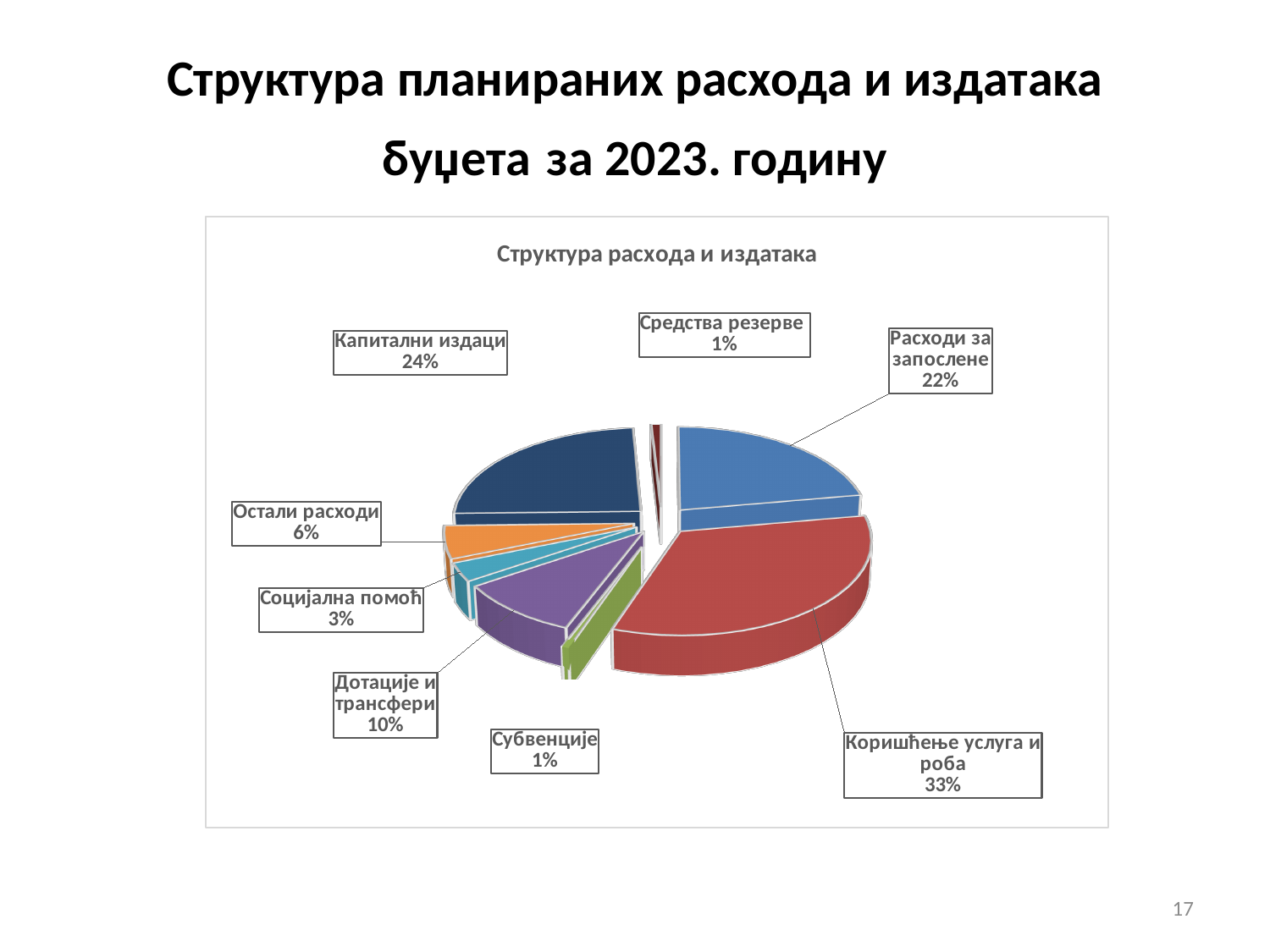
What is the title of the chart? Структура расхода и издатака What share of the pie is Коришћење услуга и роба? 33% What share of the pie is Капитални издаци? 24% What share of the pie is Средства резерве? 1% What type of chart is shown on the slide? pie chart Which category has the largest share of the pie? Коришћење услуга и роба What is the difference in percentage points between Коришћење услуга и роба and Расходи за запослене? 11 Which is larger, the share for Остали расходи or the share for Социјална помоћ? Остали расходи How many categories (slices) does the pie chart show? 8